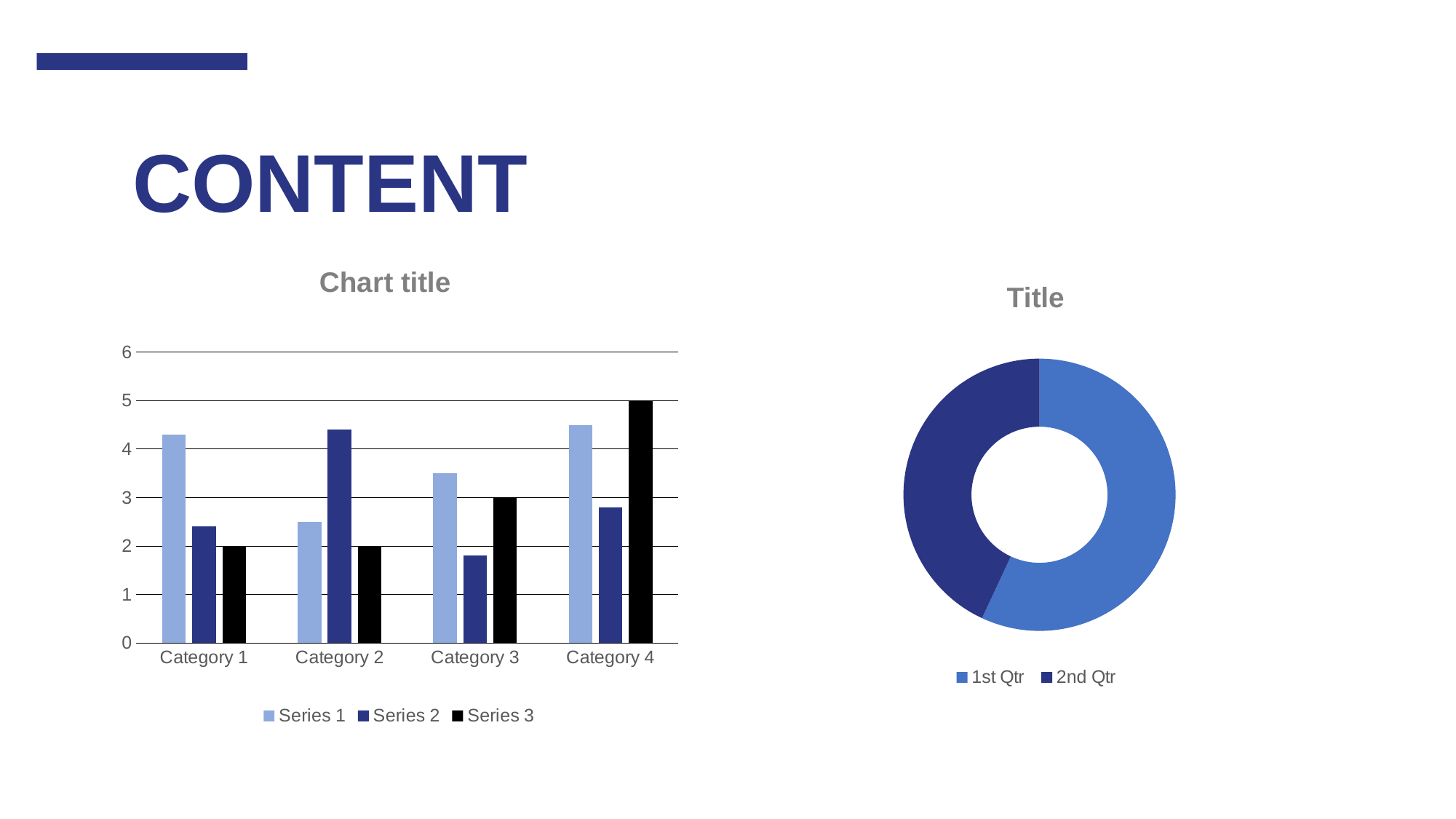
In the chart titled "Chart title", which category has the highest value for Series 3? Category 4 In the chart titled "Chart title", what is the difference between the Series 3 values for Category 4 and Category 1? 3 In the chart titled "Title", how many entries does the legend list? 2 What kind of chart is the chart titled "Title" on the right? doughnut chart In the chart titled "Chart title", how many categories are shown on the x axis? 4 In the chart titled "Title", which slice is larger, 1st Qtr or 2nd Qtr? 1st Qtr In the chart titled "Chart title", is the value of Series 1 for Category 1 greater or less than 4? greater In the chart titled "Chart title", what is the value of Series 3 for Category 4? 5 What kind of chart is the chart titled "Chart title"? bar chart In the chart titled "Chart title", what is the value of Series 3 for Category 3? 3 In the chart titled "Chart title", how many series does the legend list? 3 In the chart titled "Chart title", which is larger for Category 2, Series 1 or Series 2? Series 2